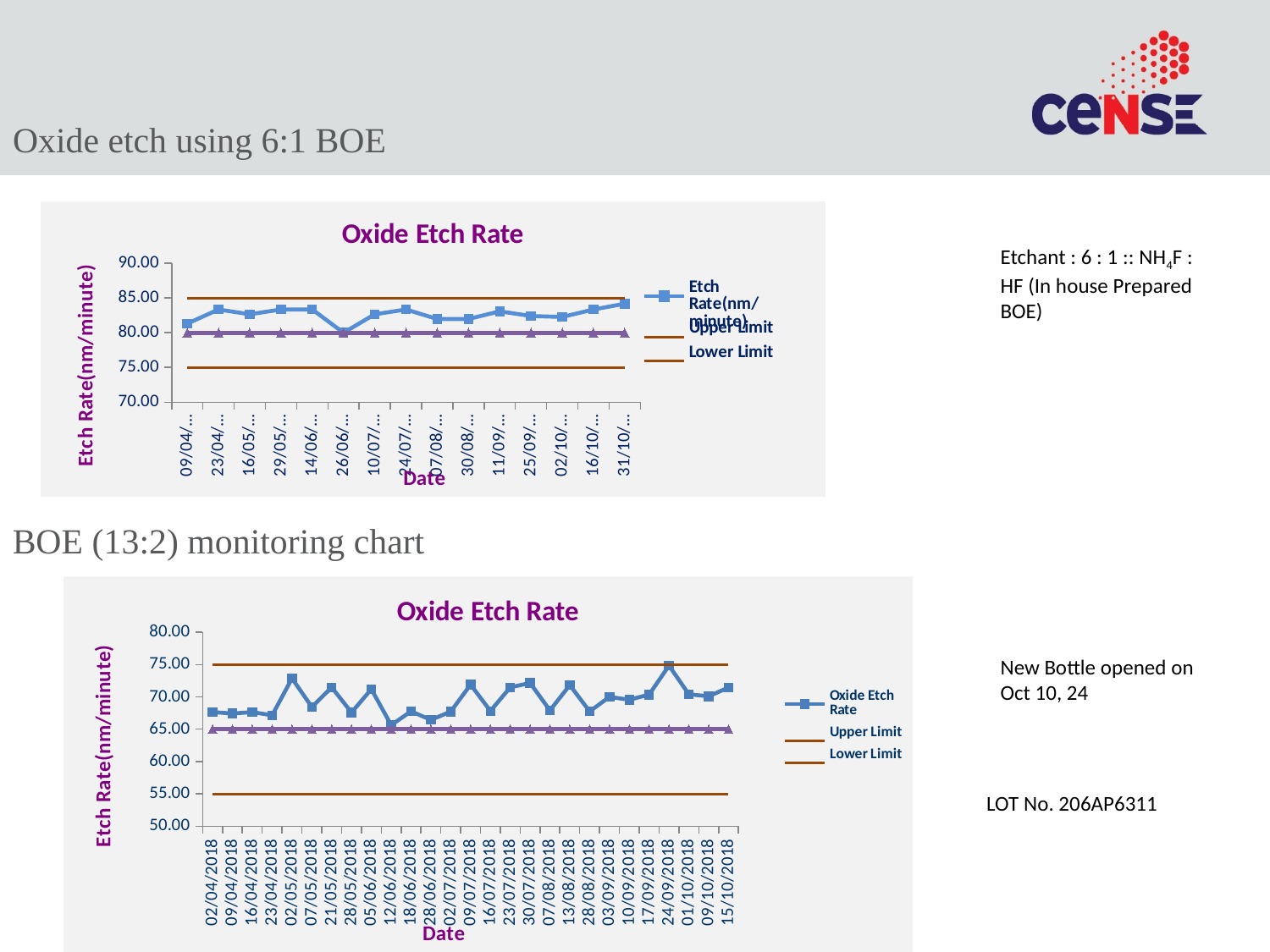
In the bottom chart, on which date is the Oxide Etch Rate highest? 24/09/2018 In the bottom chart, what is the value of the Upper Limit line? 75.00 In the top chart, on which date is the etch rate lowest? 26/06 In the top chart, what is the value of the Lower Limit line? 75.00 How many data points are plotted on the bottom chart's x axis? 27 What type of chart is the top chart on the slide? line chart In the top chart, what is the value of the Upper Limit line? 85.00 How many series does the legend of the bottom chart list? 3 What is the y-axis label of the bottom chart? Etch Rate(nm/minute) In the bottom chart, what is the value of the Lower Limit line? 55.00 In the bottom chart, is the Oxide Etch Rate for 02/05/2018 greater or less than 70.00? greater In the bottom chart, is the Oxide Etch Rate for 12/06/2018 greater or less than 70.00? less